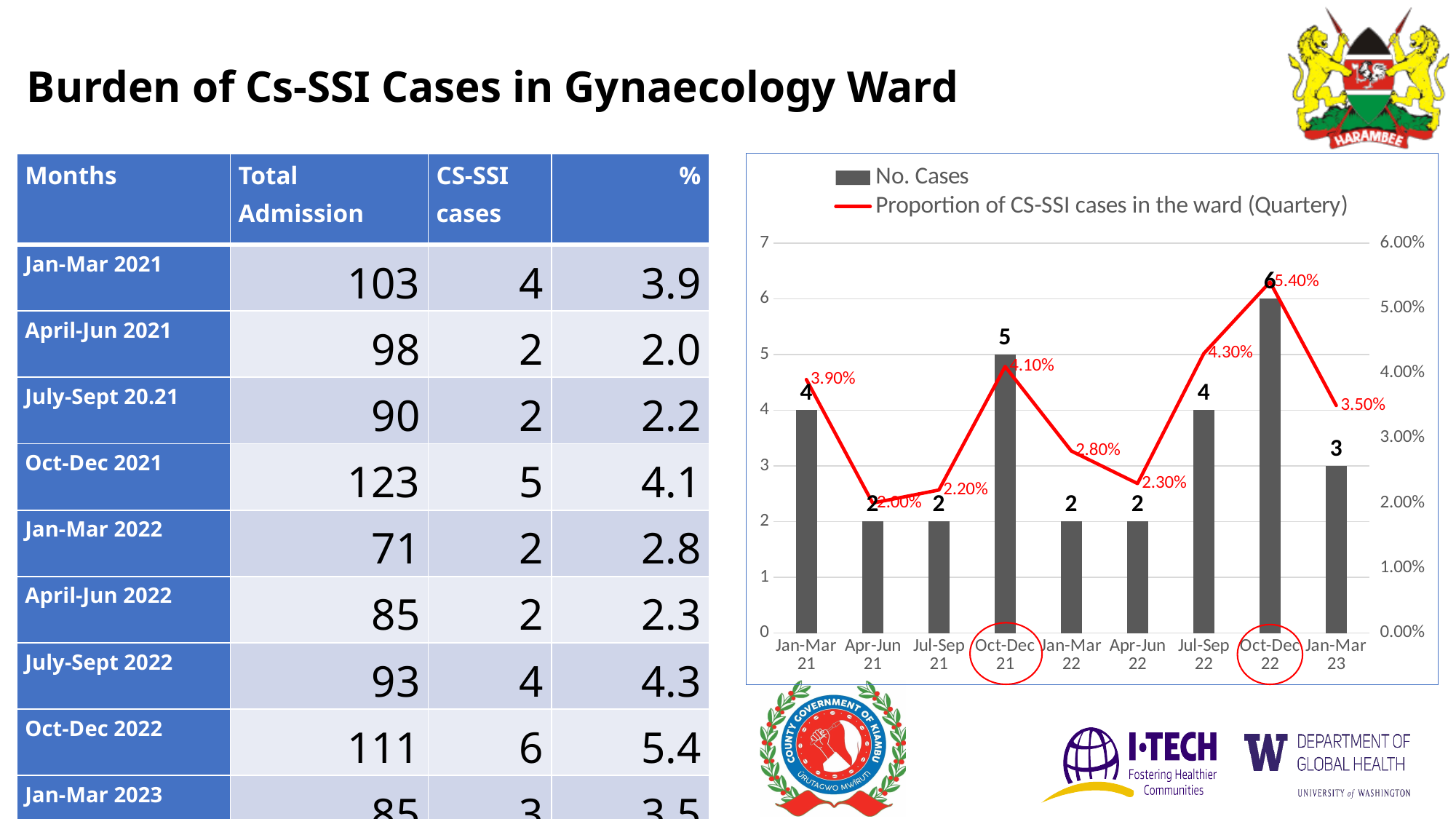
Is the number of cases for Oct-Dec 21 greater or less than 4? greater What is the number of cases for Oct-Dec 22? 6 What is the number of cases for Jan-Mar 23? 3 Which is larger, the proportion of CS-SSI cases for Jan-Mar 21 or for Jan-Mar 22? Jan-Mar 21 How many series does the chart legend list? 2 What is the difference in number of cases between Oct-Dec 22 and Oct-Dec 21? 1 Which quarter has the highest number of cases? Oct-Dec 22 What colour is the line showing the proportion of CS-SSI cases in the ward? Red How many quarters are shown on the x axis of the chart? 9 What is the proportion of CS-SSI cases in the ward for Jul-Sep 22? 4.30% Which quarter has the lowest proportion of CS-SSI cases in the ward? Apr-Jun 21 What kind of chart is used to show the number of cases? Bar chart